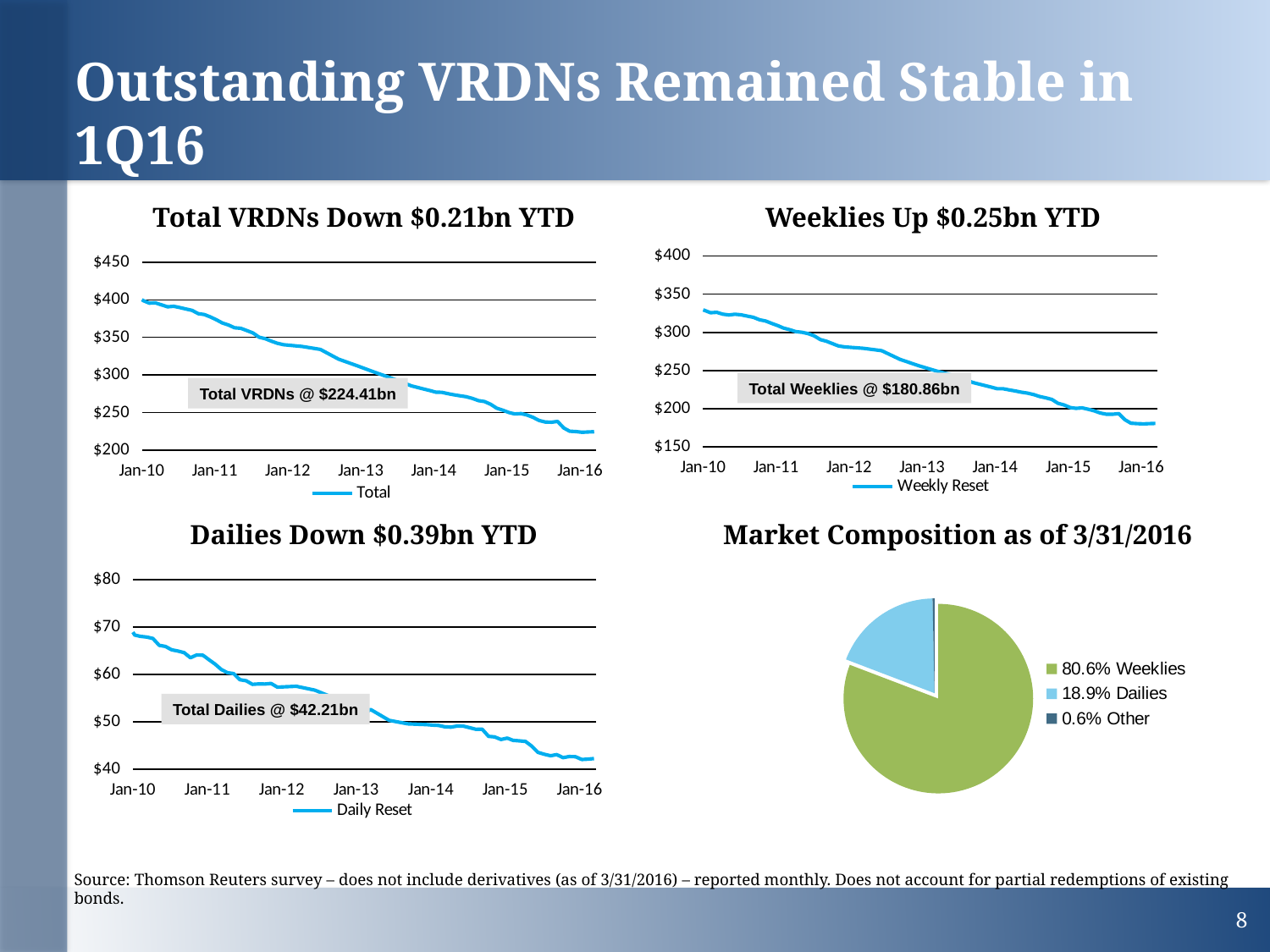
What kind of chart is 'Total VRDNs Down $0.21bn YTD'? Line chart In the 'Dailies Down $0.39bn YTD' chart, what value is given in the annotation for Total Dailies? $42.21bn In the 'Total VRDNs Down $0.21bn YTD' chart, what value is given in the annotation for Total VRDNs? $224.41bn In the 'Weeklies Up $0.25bn YTD' chart, is the value at Jan-10 greater or less than $300? greater In the 'Dailies Down $0.39bn YTD' chart, is the value at Jan-16 greater or less than $50? less What kind of chart is 'Market Composition as of 3/31/2016'? Pie chart How many categories does the 'Market Composition as of 3/31/2016' pie chart show? 3 In the 'Weeklies Up $0.25bn YTD' chart, what value is given in the annotation for Total Weeklies? $180.86bn In the 'Dailies Down $0.39bn YTD' chart, what is the legend entry for the plotted line? Daily Reset In the 'Market Composition as of 3/31/2016' pie chart, which category has the smallest share? Other In the 'Market Composition as of 3/31/2016' pie chart, what share do Weeklies have? 80.6% In the 'Total VRDNs Down $0.21bn YTD' chart, do the values rise or fall from Jan-10 to Jan-16? Fall